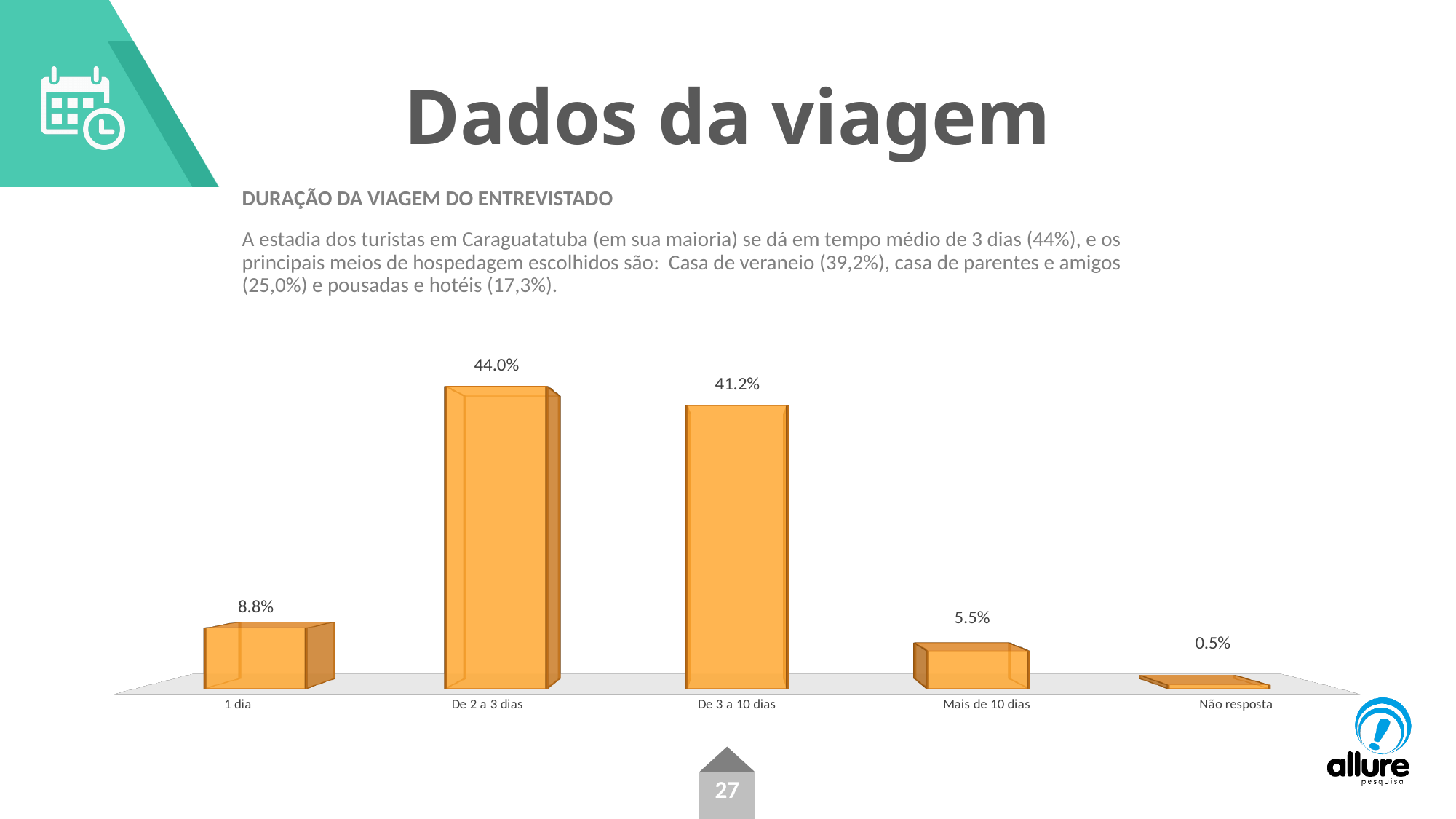
What kind of chart is shown on the slide? Bar chart Which is larger, the value for '1 dia' or the value for 'Mais de 10 dias'? 1 dia What is the value for '1 dia'? 8.8% What colour are the bars in the chart? Orange What is the difference between the values for '1 dia' and 'Não resposta'? 8.3% How many categories are shown on the chart? 5 Which category has the lowest value? Não resposta Which category has the highest value? De 2 a 3 dias What is the value for 'Não resposta'? 0.5% What is the difference between the values for 'De 2 a 3 dias' and 'De 3 a 10 dias'? 2.8% What is the value for 'Mais de 10 dias'? 5.5% What is the value for 'De 2 a 3 dias'? 44.0%